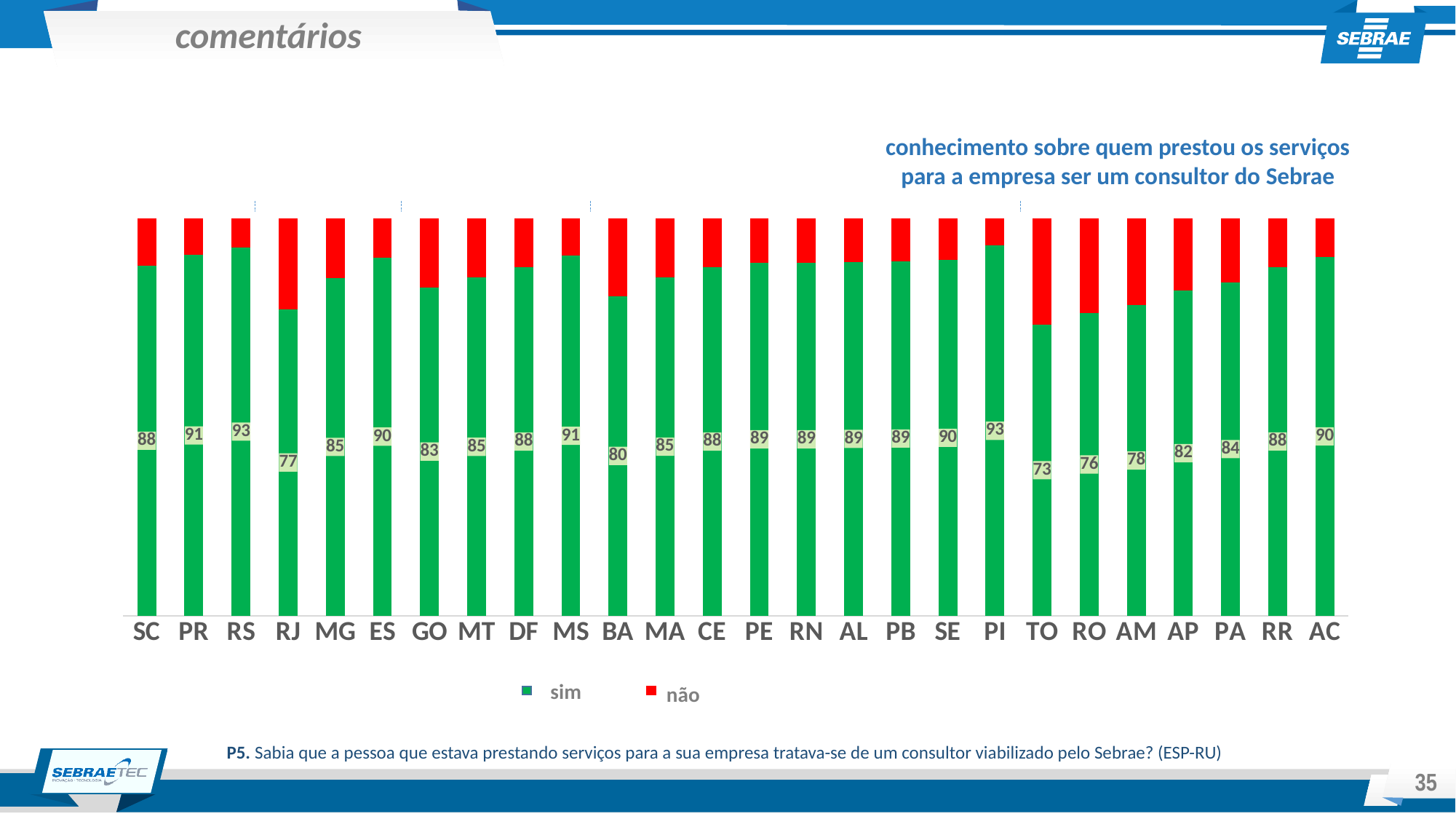
What is the difference between the 'sim' values for RS and RJ? 16 How many states are shown on the x axis of the chart? 26 How many series does the legend list? 2 What is the 'sim' value for TO? 73 What is the 'sim' value for RJ? 77 What is the difference between the 'sim' values for PI and TO? 20 Which has a larger 'sim' value, RJ or MG? MG What kind of chart is shown on the slide? Stacked bar chart What is the 'sim' value for BA? 80 Which has a larger 'sim' value, TO or RO? RO What is the 'sim' value for PI? 93 Which state has the lowest 'sim' value? TO